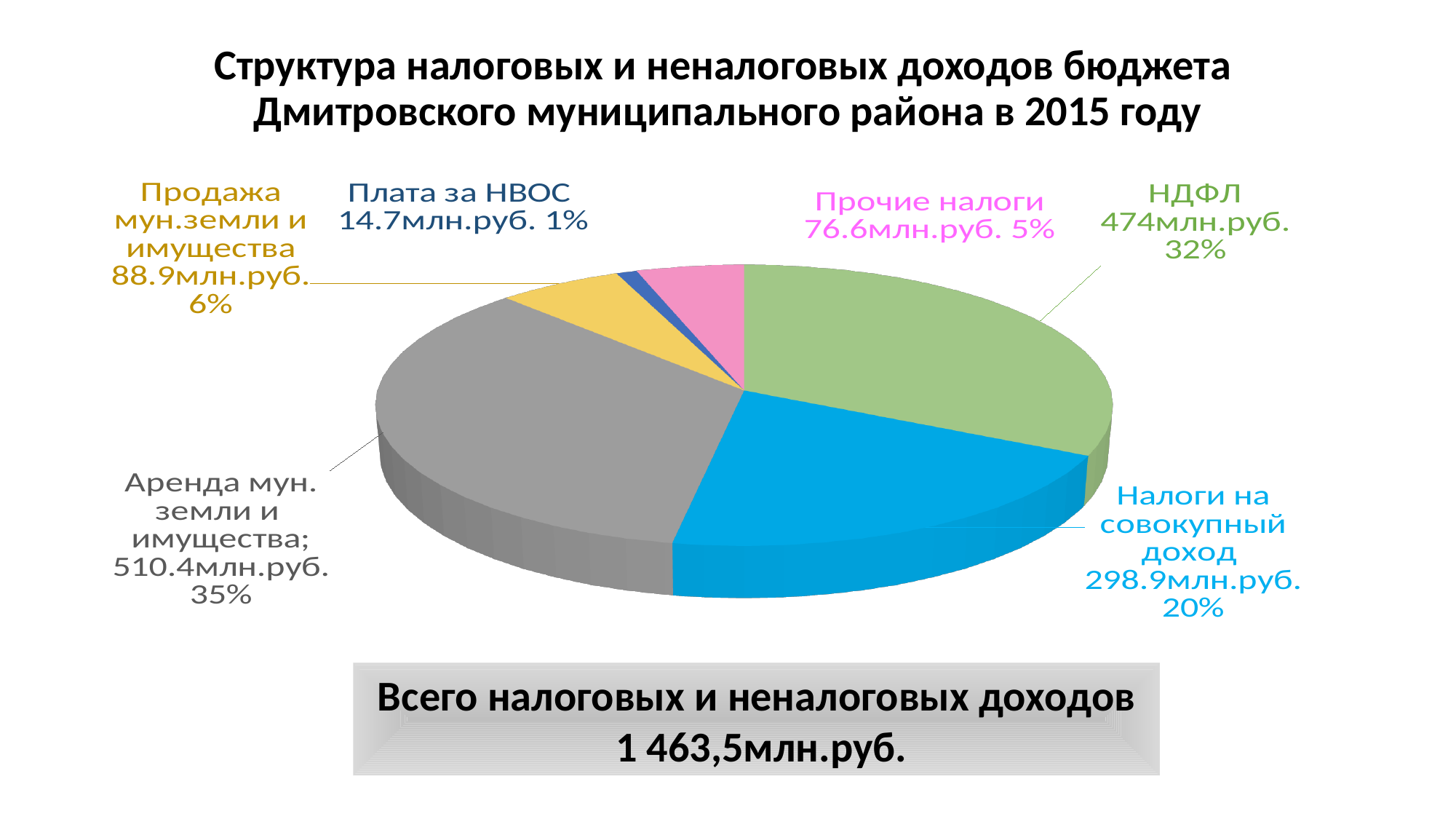
How many slices does the pie chart have? 6 What is the difference in percentage points between НДФЛ and Налоги на совокупный доход? 12% What is the value for Налоги на совокупный доход? 298.9млн.руб. What colour is the slice for Прочие налоги? pink Which category has the smallest slice of the pie? Плата за НВОС What share of the pie does Аренда мун. земли и имущества represent? 35% What is the total of tax and non-tax revenues shown on the slide? 1 463,5млн.руб. Which category has the largest slice of the pie? Аренда мун. земли и имущества Which is larger: Прочие налоги or Продажа мун.земли и имущества? Продажа мун.земли и имущества What is the value for НДФЛ? 474млн.руб. What kind of chart is shown on the slide? pie chart What percentage share is shown for Плата за НВОС? 1%